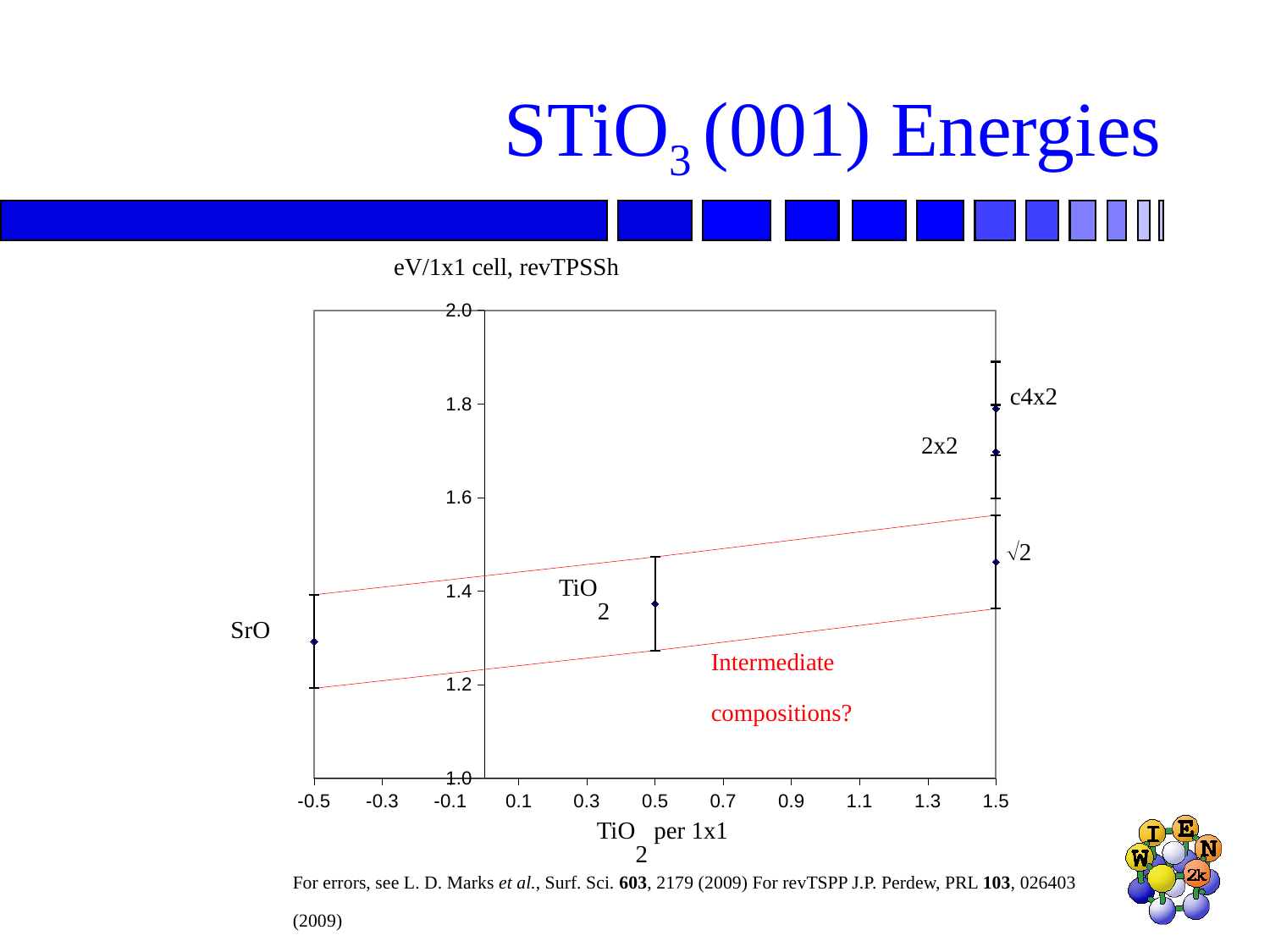
Which has the larger energy value, 2x2 or √2? 2x2 At what x-axis value (TiO2 per 1x1) is the SrO point plotted? -0.5 Which labelled point has the highest energy value? c4x2 Is the value for c4x2 greater or less than 1.6? greater Is the value for √2 greater or less than 1.6? less Which has the larger energy value, c4x2 or 2x2? c4x2 Which labelled point has the lowest energy value? SrO Is the value for 2x2 greater or less than 1.8? less What is the label on the y axis of the chart? eV/1x1 cell, revTPSSh How many labelled data points are plotted on the chart? 5 What kind of chart is shown on the slide? scatter chart